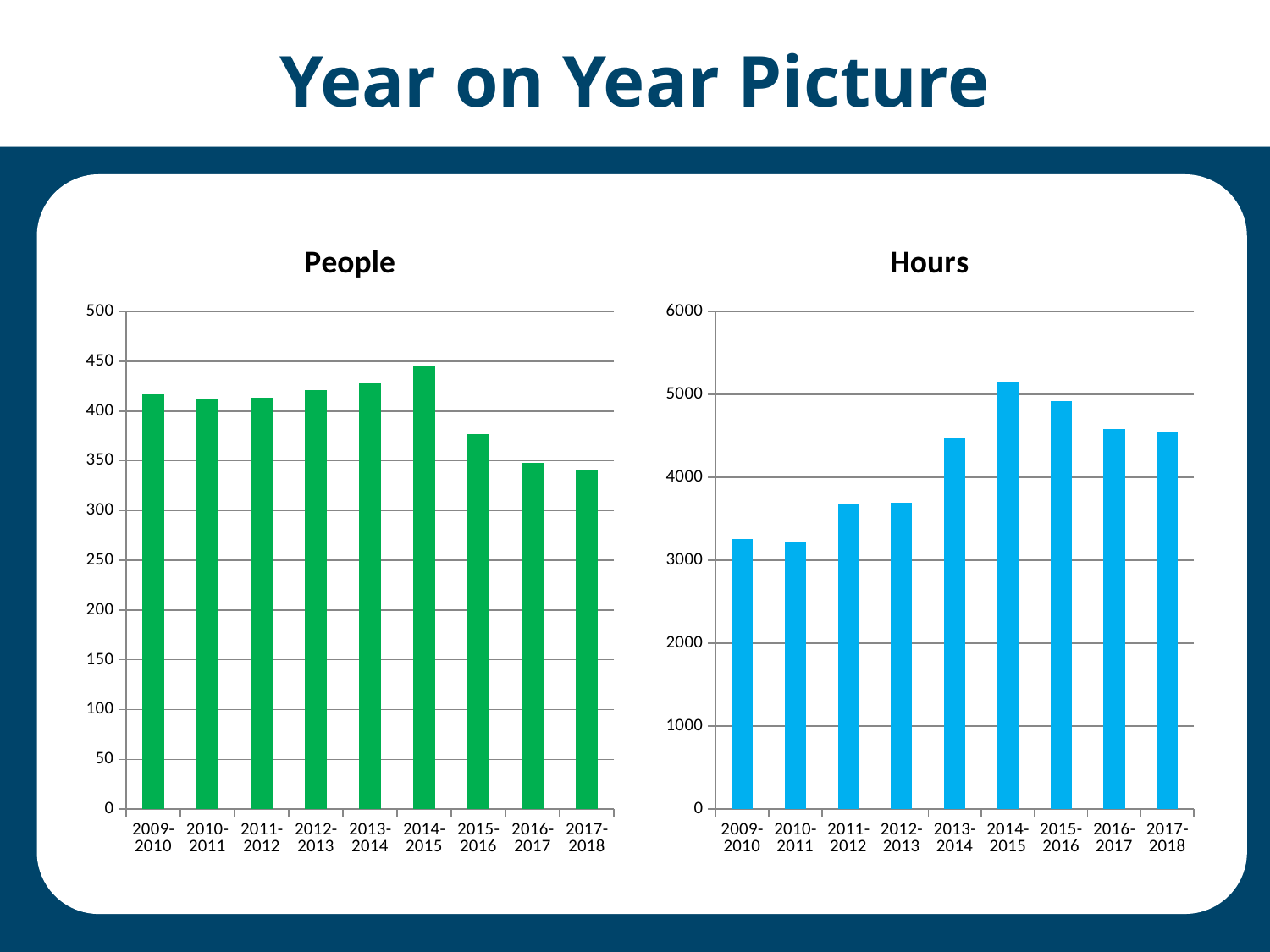
In the Hours chart, is the value for 2015-2016 greater or less than 5000? less In the Hours chart, is the value for 2009-2010 greater or less than 3000? greater How many year categories are shown on the Hours chart? 9 In the People chart, do the values rise or fall from 2014-2015 to 2017-2018? fall What kind of chart is the People chart? bar chart In the Hours chart, is the value for 2014-2015 greater or less than 5000? greater In the Hours chart, which is larger, the value for 2011-2012 or the value for 2013-2014? 2013-2014 In the Hours chart, which year has the highest value? 2014-2015 In the People chart, which is larger, the value for 2014-2015 or the value for 2015-2016? 2014-2015 In the People chart, which year has the highest value? 2014-2015